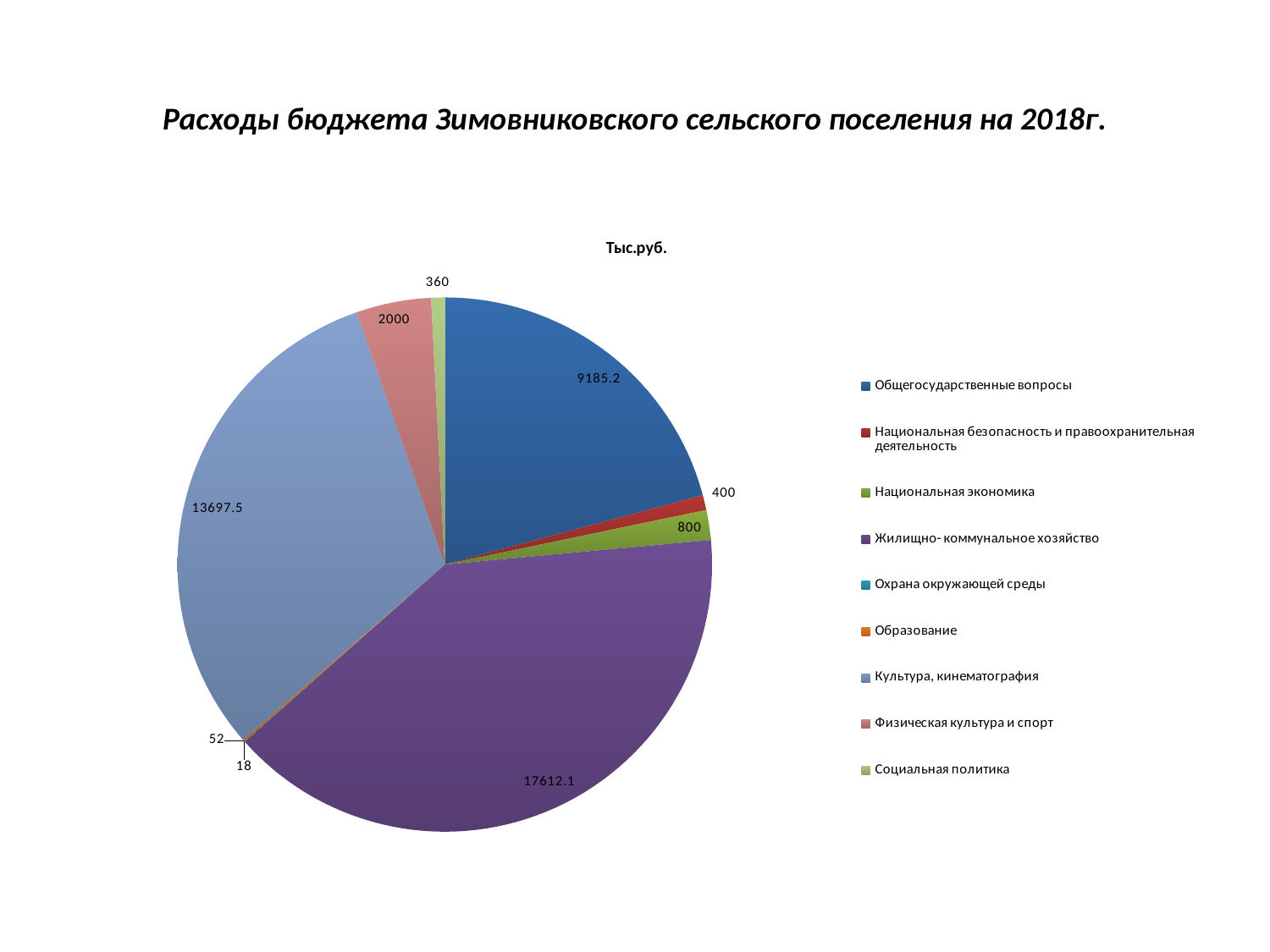
What is the value for Социальная политика? 360 What is the value for Национальная безопасность и правоохранительная деятельность? 400 What is the value for Национальная экономика? 800 What is the difference between the values for Жилищно-коммунальное хозяйство and Культура, кинематография? 3914.6 What is the value for Жилищно-коммунальное хозяйство? 17612.1 What is the value for Культура, кинематография? 13697.5 Which is larger: Общегосударственные вопросы or Культура, кинематография? Культура, кинематография What is the value for Физическая культура и спорт? 2000 What is the value for Общегосударственные вопросы? 9185.2 What type of chart is shown on the slide? Pie chart Which category has the largest slice of the pie? Жилищно-коммунальное хозяйство How many categories does the legend list? 9